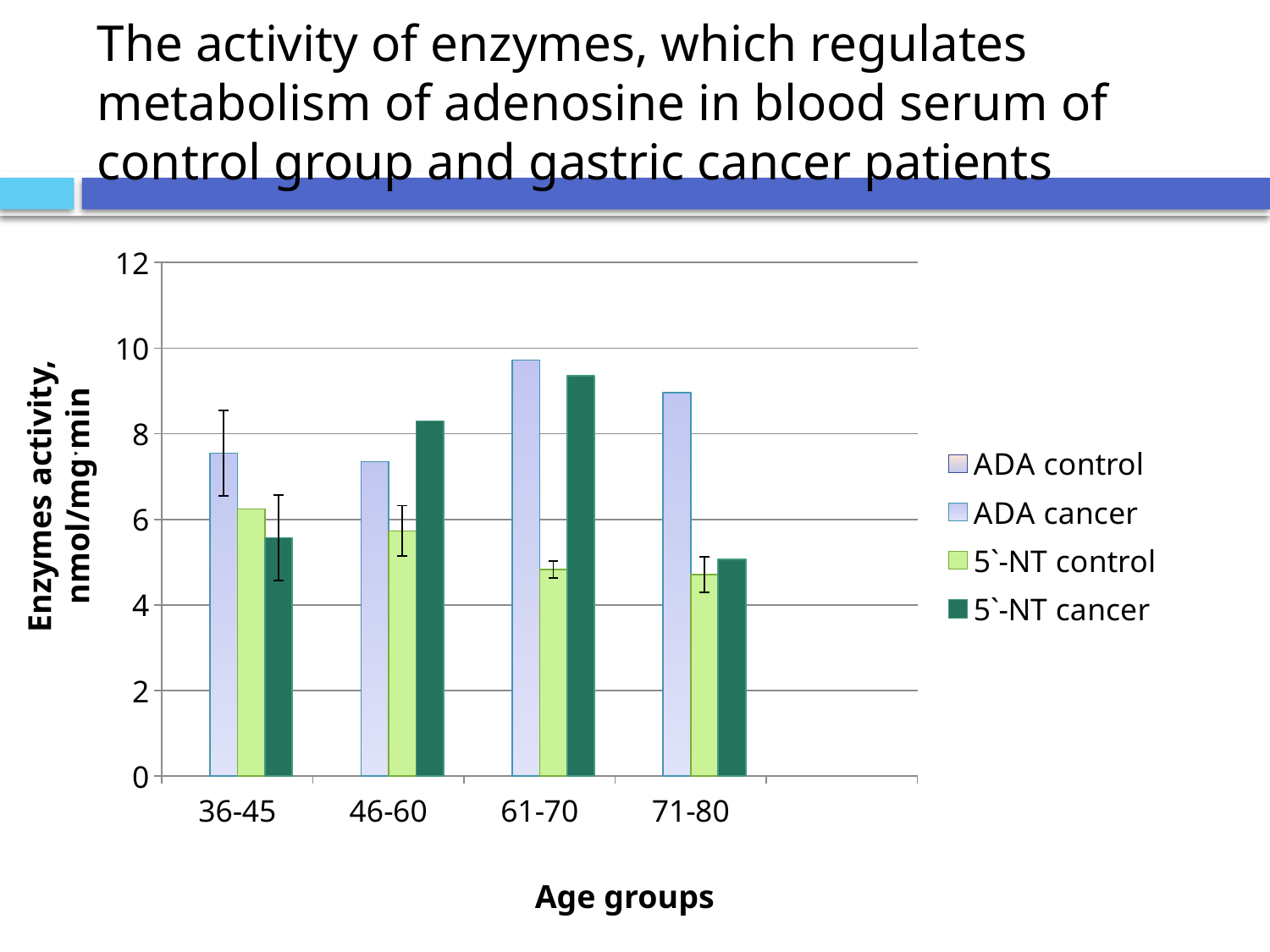
Which age group has the highest value for 5`-NT cancer? 61-70 Does the value for 5`-NT control rise or fall across the age groups from 36-45 to 71-80? fall Is the value for 5`-NT cancer in the 61-70 age group greater or less than 8? greater How many age groups are shown on the x axis? 4 What is the title of the x axis? Age groups Is the value for 5`-NT cancer in the 36-45 age group greater or less than 6? less What kind of chart is shown on the slide? bar chart In the 46-60 age group, which is larger: 5`-NT cancer or 5`-NT control? 5`-NT cancer Which age group has the highest value for 5`-NT control? 36-45 Is the value for 5`-NT cancer in the 46-60 age group greater or less than 8? greater How many series does the legend list? 4